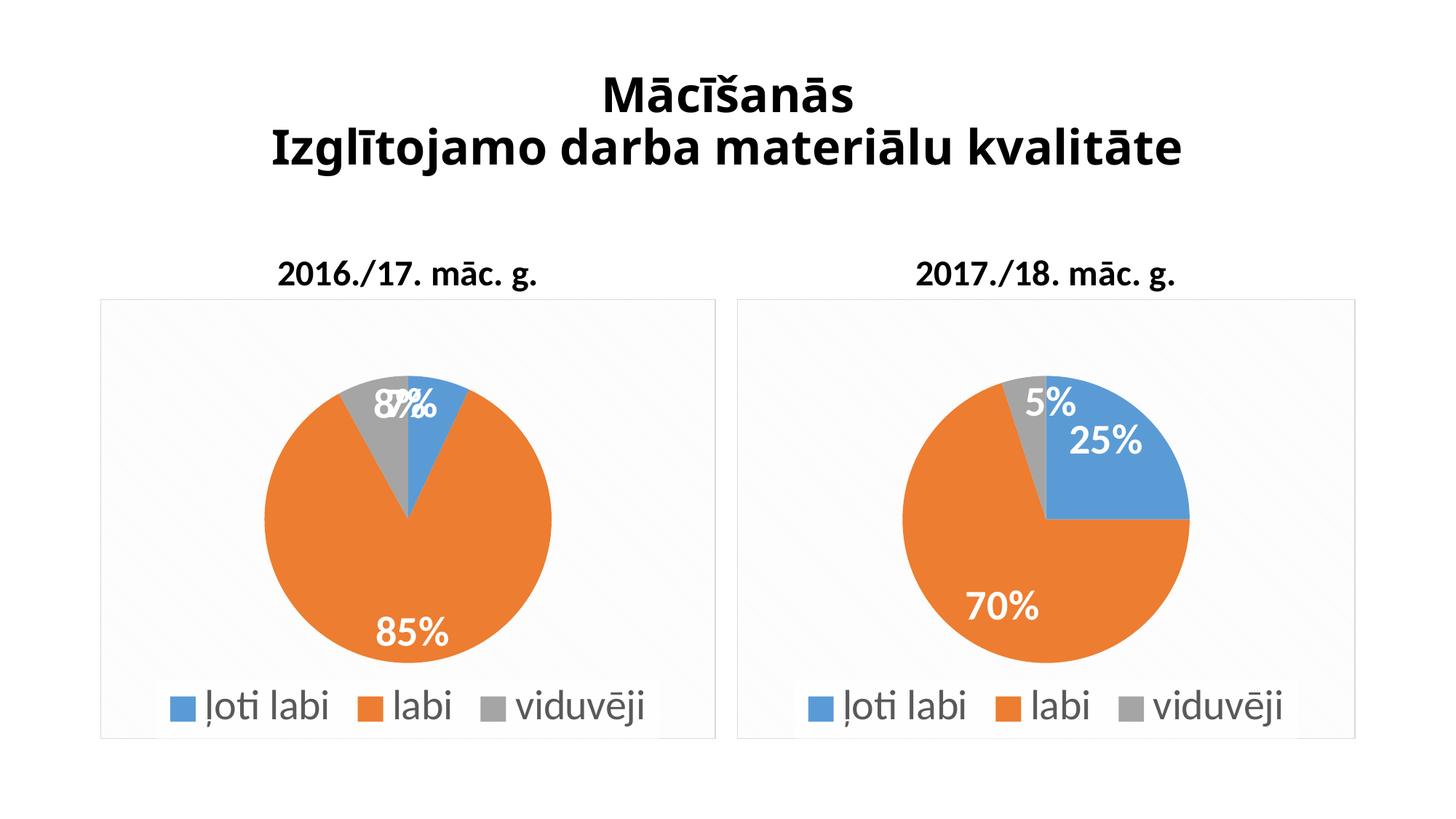
In the 2017./18. māc. g. chart, what is the difference between the "labi" and "ļoti labi" shares? 45% In the 2017./18. māc. g. chart, which category has the largest slice? labi In the 2017./18. māc. g. chart, what share is labelled for "labi"? 70% In the 2016./17. māc. g. chart, which category has the largest slice? labi In the 2017./18. māc. g. chart, what share is labelled for "ļoti labi"? 25% What type of chart is used for the 2017./18. māc. g. data? Pie chart How many categories does the legend of the 2016./17. māc. g. chart list? 3 In the 2017./18. māc. g. chart, what colour represents "ļoti labi"? Blue In the 2016./17. māc. g. chart, what share is labelled for "labi"? 85% In the 2017./18. māc. g. chart, what share is labelled for "viduvēji"? 5% In the 2017./18. māc. g. chart, which category has the smallest slice? viduvēji Which is larger: the "labi" share in the 2016./17. māc. g. chart or the "labi" share in the 2017./18. māc. g. chart? 2016./17. māc. g.